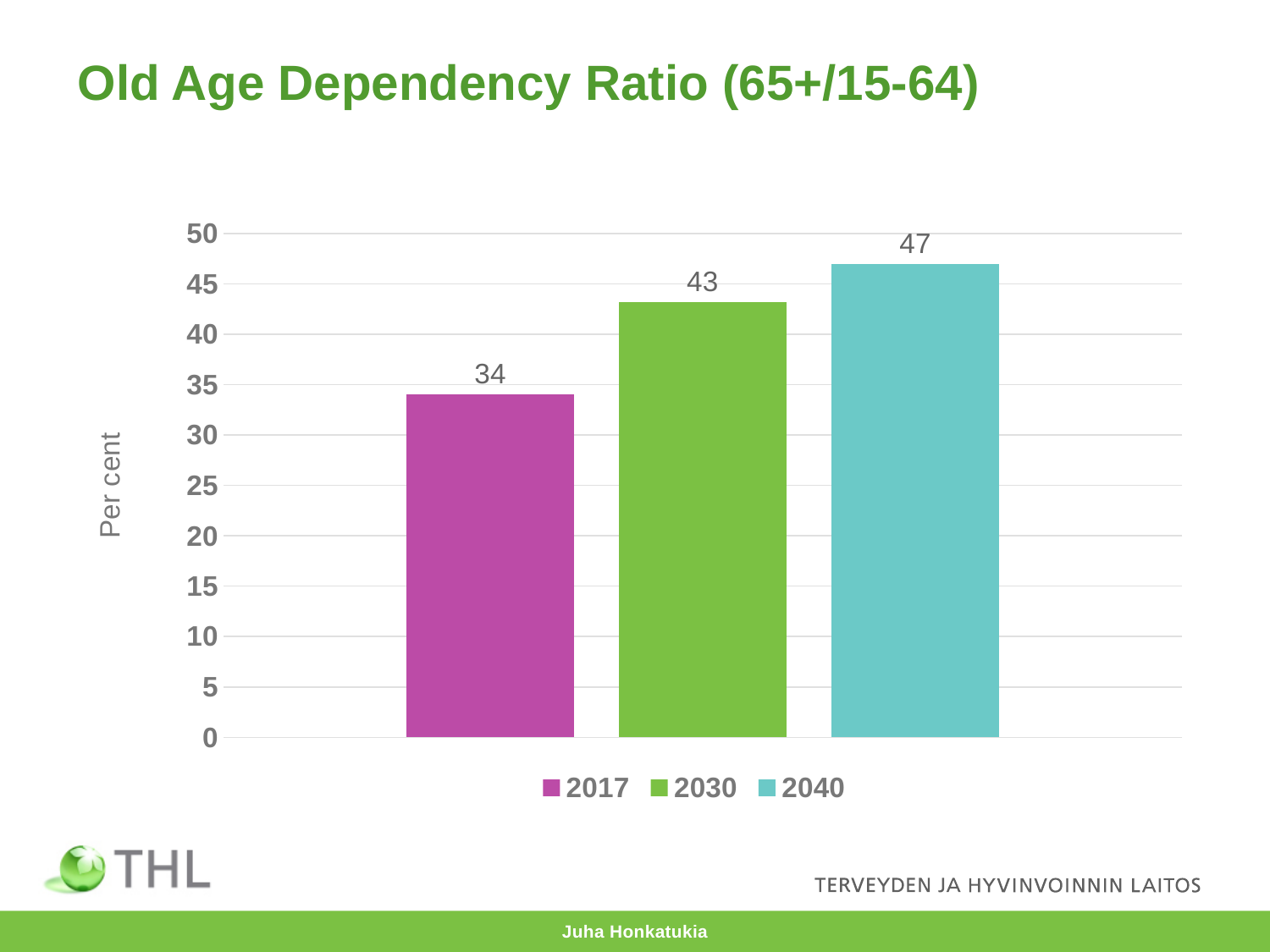
Which year has the lowest old age dependency ratio? 2017 What is the difference between the 2040 and 2017 values? 13 What is the difference between the 2030 and 2017 values? 9 Is the value for 2017 greater or less than 40? less How many series does the legend list? 3 Which year has the highest old age dependency ratio? 2040 Which is larger, the value for 2030 or the value for 2040? 2040 What kind of chart is shown on the slide? bar chart What is the old age dependency ratio for 2040? 47 What is the label on the vertical axis? Per cent What is the old age dependency ratio for 2017? 34 What is the old age dependency ratio for 2030? 43